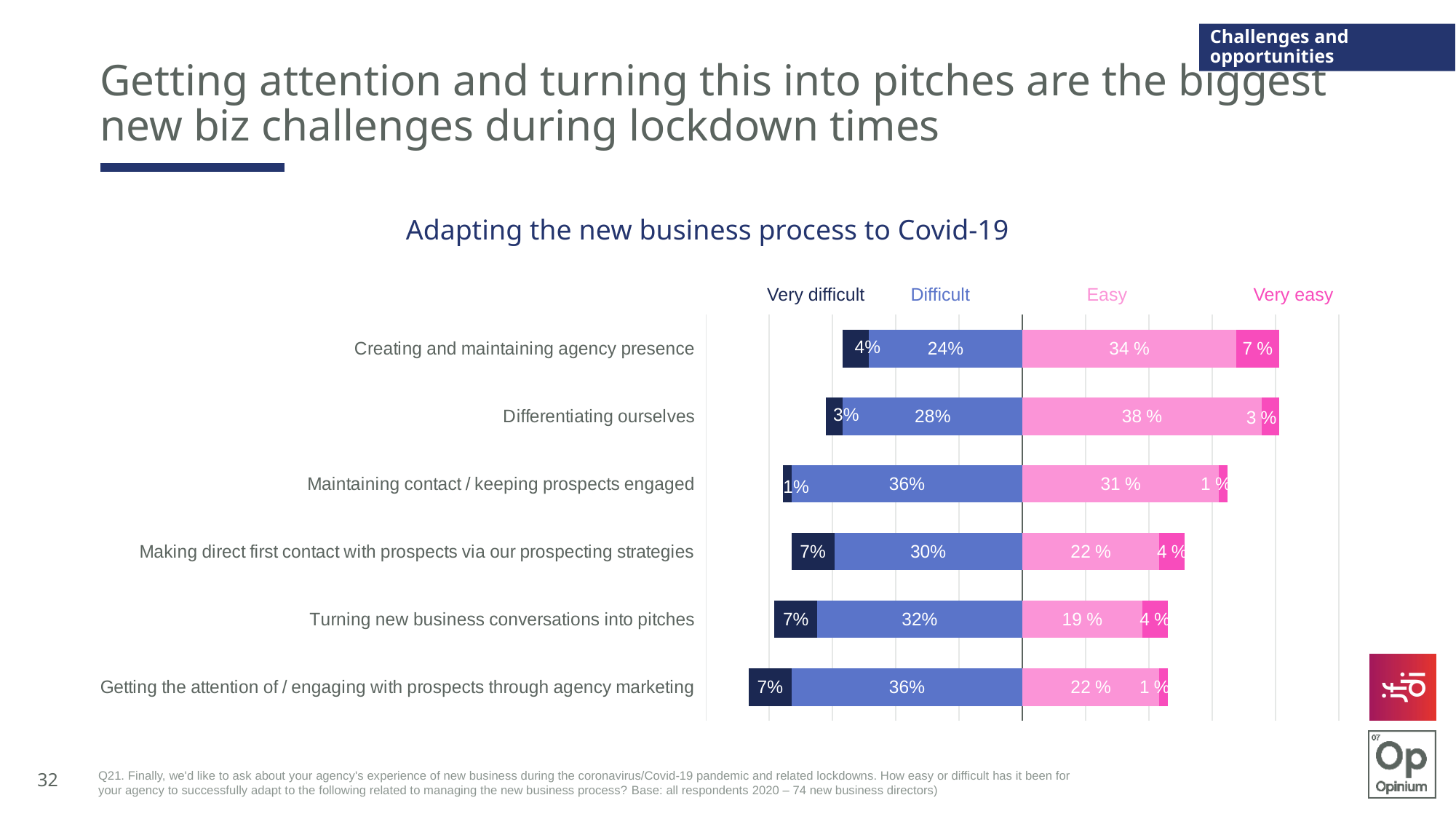
What is the 'Very easy' value for 'Making direct first contact with prospects via our prospecting strategies'? 4 % How many categories are shown in the chart? 6 What is the 'Difficult' value for 'Turning new business conversations into pitches'? 32% Which category has the highest 'Easy' value? Differentiating ourselves What is the title of the chart? Adapting the new business process to Covid-19 Which category has the highest 'Very easy' value? Creating and maintaining agency presence Which is larger: the 'Difficult' value for 'Differentiating ourselves' or for 'Making direct first contact with prospects via our prospecting strategies'? Making direct first contact with prospects via our prospecting strategies Which category has the lowest 'Easy' value? Turning new business conversations into pitches How many series does the legend list? 4 What is the difference between the 'Easy' values for 'Differentiating ourselves' and 'Turning new business conversations into pitches'? 19 percentage points What is the 'Very difficult' value for 'Creating and maintaining agency presence'? 4% What percentage of respondents found 'Differentiating ourselves' Easy? 38 %